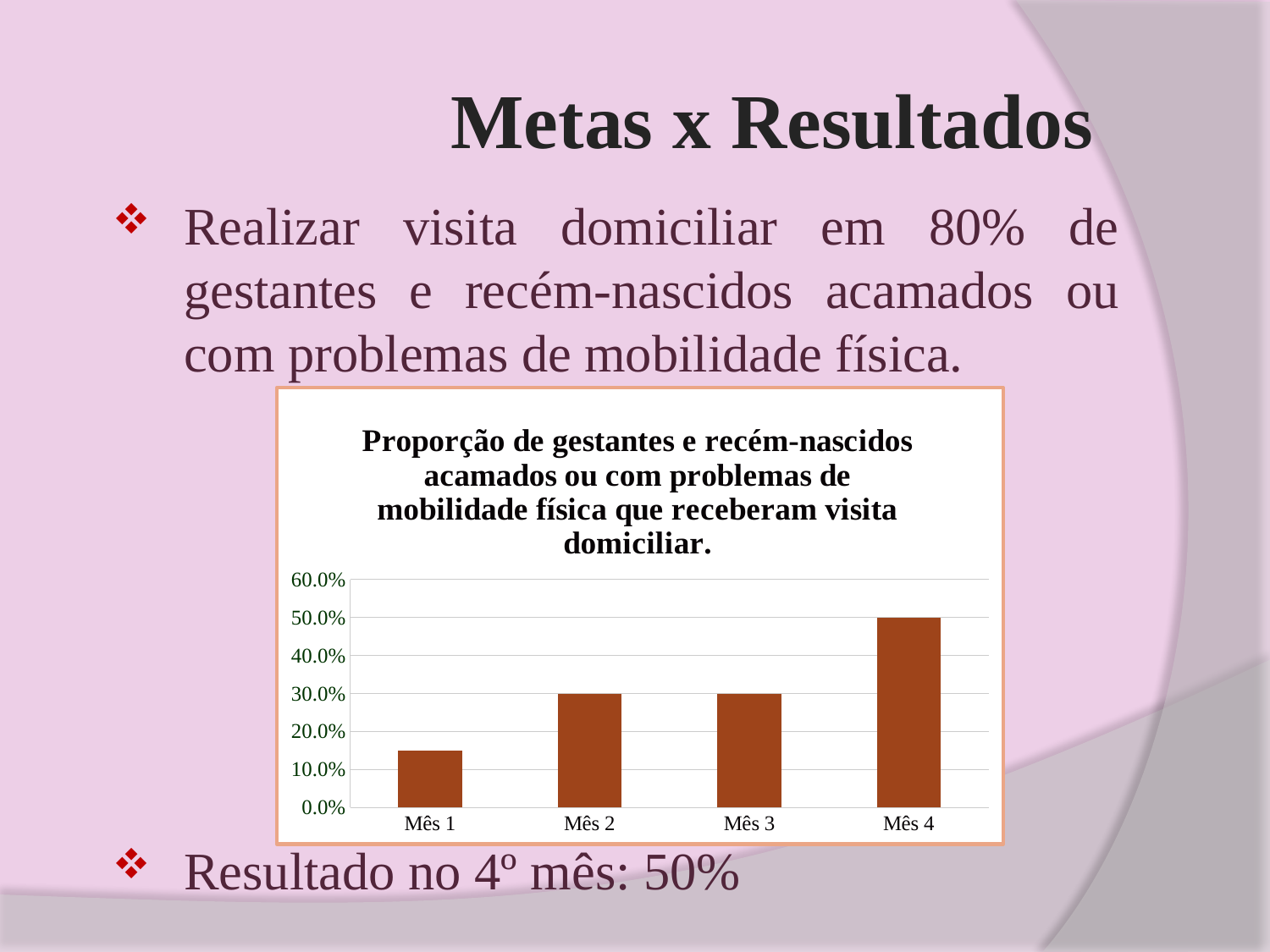
What is the value for Mês 3 in the chart? 30.0% Which is larger, the value for Mês 1 or the value for Mês 4? Mês 4 Which month has the highest value in the chart? Mês 4 Is the value for Mês 1 greater or less than 20.0%? less Do the values generally rise or fall from Mês 1 to Mês 4? rise Which month has the lowest value in the chart? Mês 1 What type of chart is shown on the slide? bar chart How many months (categories) are shown on the x axis of the chart? 4 Is the value for Mês 1 greater or less than 10.0%? greater What is the value for Mês 2 in the chart? 30.0% What is the value for Mês 4 in the chart? 50.0% What is the difference between the value for Mês 4 and the value for Mês 2? 20.0%